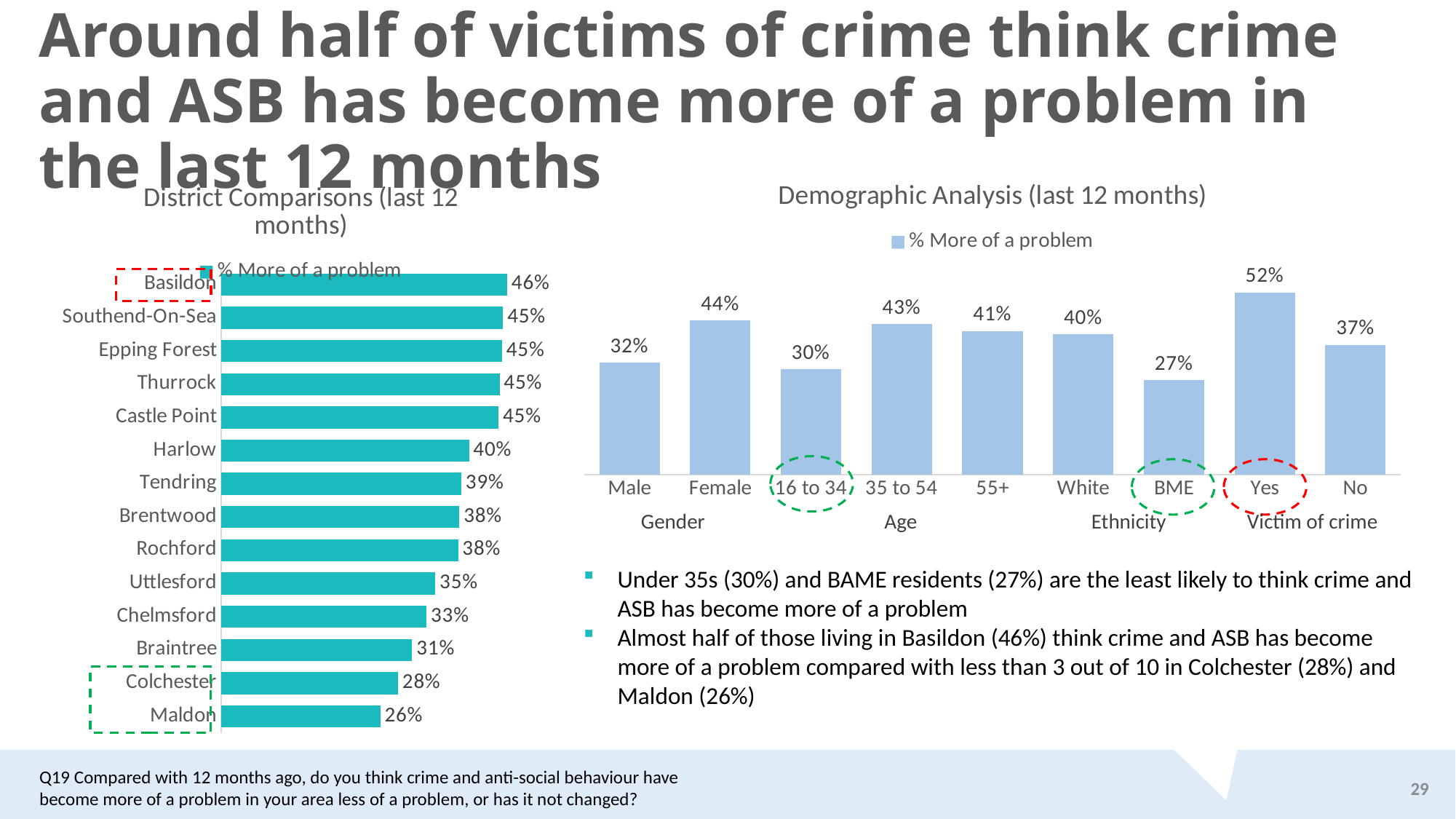
In the Demographic Analysis chart, what is the difference between Yes and No under Victim of crime? 15% In the District Comparisons chart, which district has the lowest value? Maldon How many series does the legend of the Demographic Analysis chart list? 1 In the Demographic Analysis chart, what is the value for BME? 27% In the Demographic Analysis chart, which category has the lowest value? BME In the District Comparisons chart, how many districts are shown? 14 In the Demographic Analysis chart, which category has the highest value? Yes In the District Comparisons chart, which district has the highest value? Basildon What type of chart is the District Comparisons chart? Bar chart In the District Comparisons chart, what is the value for Harlow? 40% In the District Comparisons chart, what is the difference between Basildon and Maldon? 20% In the Demographic Analysis chart, which is larger, Male or Female? Female